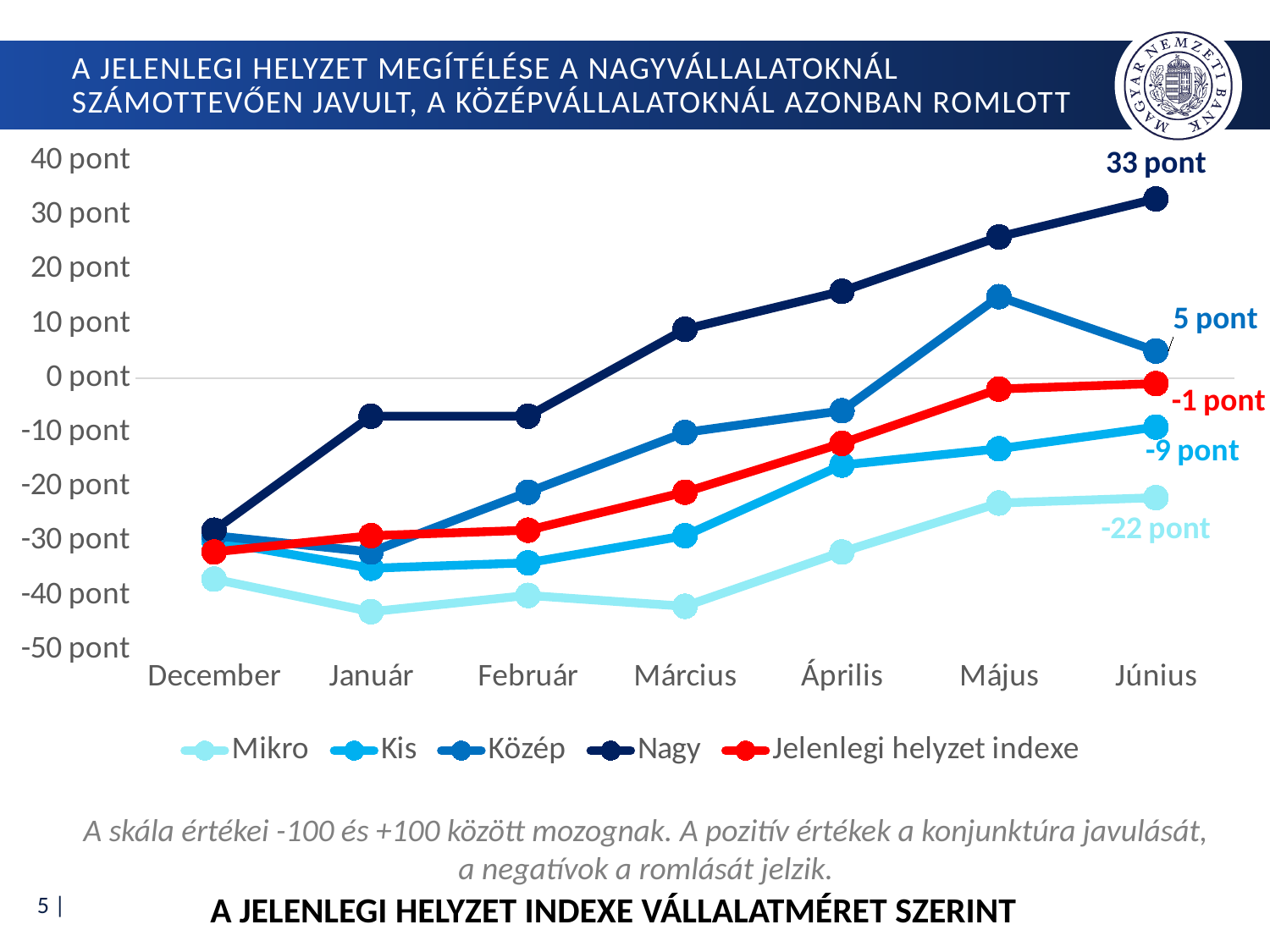
In Június, which is larger: the value for Közép or the value for Kis? Közép What kind of chart is shown on the slide? line chart Is the value for Nagy in Május greater or less than 20 pont? greater What is the value for Jelenlegi helyzet indexe in Június? -1 pont How many months are shown on the x axis? 7 What is the value for Nagy in Június? 33 pont What is the value for Mikro in Június? -22 pont What is the value for Kis in Június? -9 pont Which series has the highest value in Június? Nagy What is the difference between the Nagy and Mikro values in Június? 55 pont Which series has the lowest value in Június? Mikro How many series does the legend list? 5